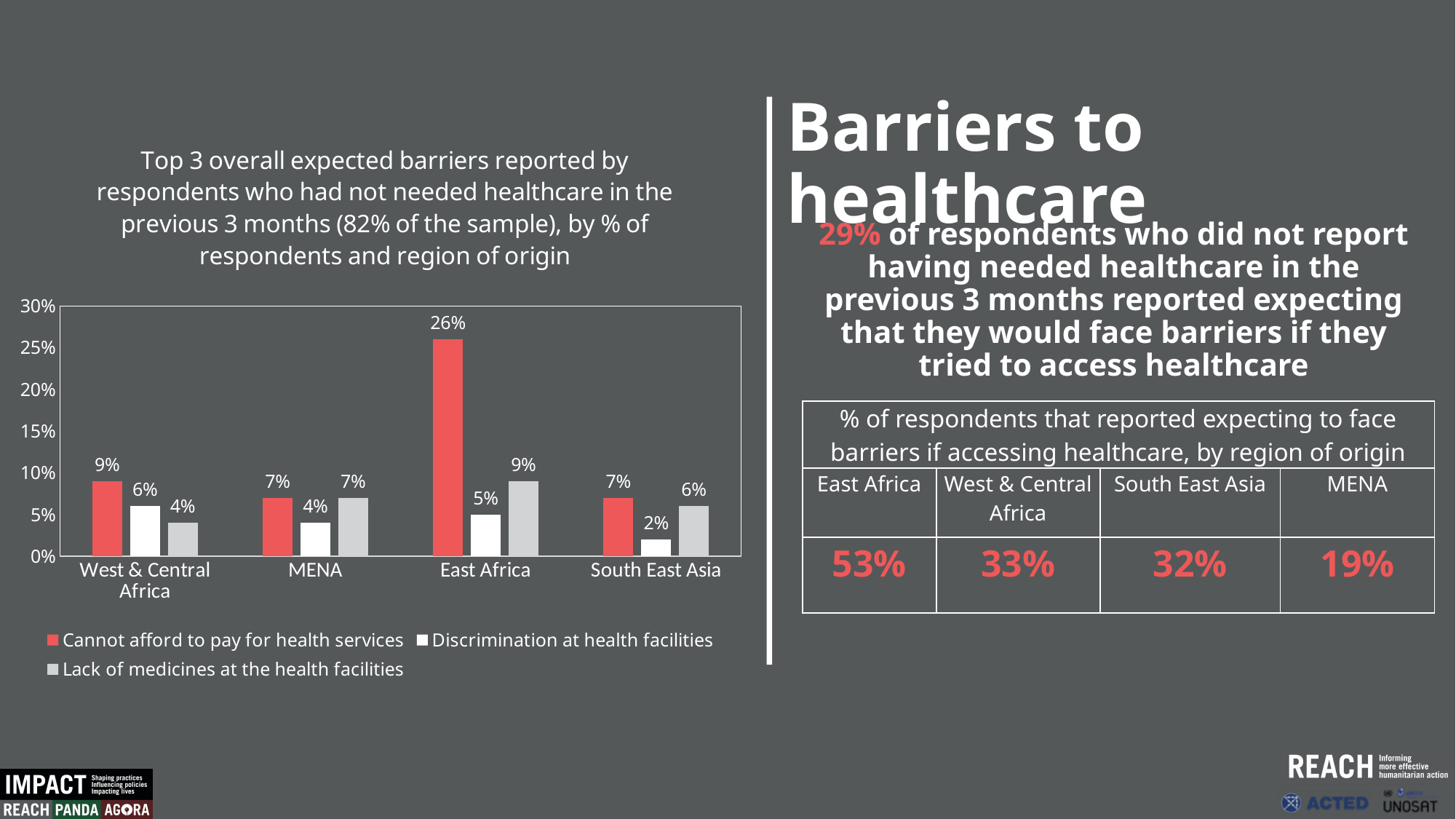
How many series does the legend of the bar chart list? 3 What is the value for 'Discrimination at health facilities' for South East Asia in the bar chart? 2% What is the value for 'Lack of medicines at the health facilities' for MENA? 7% Which region has the highest value for 'Cannot afford to pay for health services'? East Africa How many regions are shown on the x axis of the bar chart? 4 Which region has the lowest value for 'Discrimination at health facilities'? South East Asia For West & Central Africa, which is larger: 'Cannot afford to pay for health services' or 'Lack of medicines at the health facilities'? Cannot afford to pay for health services What percentage of respondents from East Africa reported 'Cannot afford to pay for health services' as an expected barrier? 26% What type of chart is used to show the top 3 expected barriers by region of origin? Bar chart What is the difference between the 'Cannot afford to pay for health services' values for East Africa and West & Central Africa? 17% Which colour represents 'Cannot afford to pay for health services' in the bar chart? Red Is the 'Cannot afford to pay for health services' value for East Africa greater or less than 20%? greater